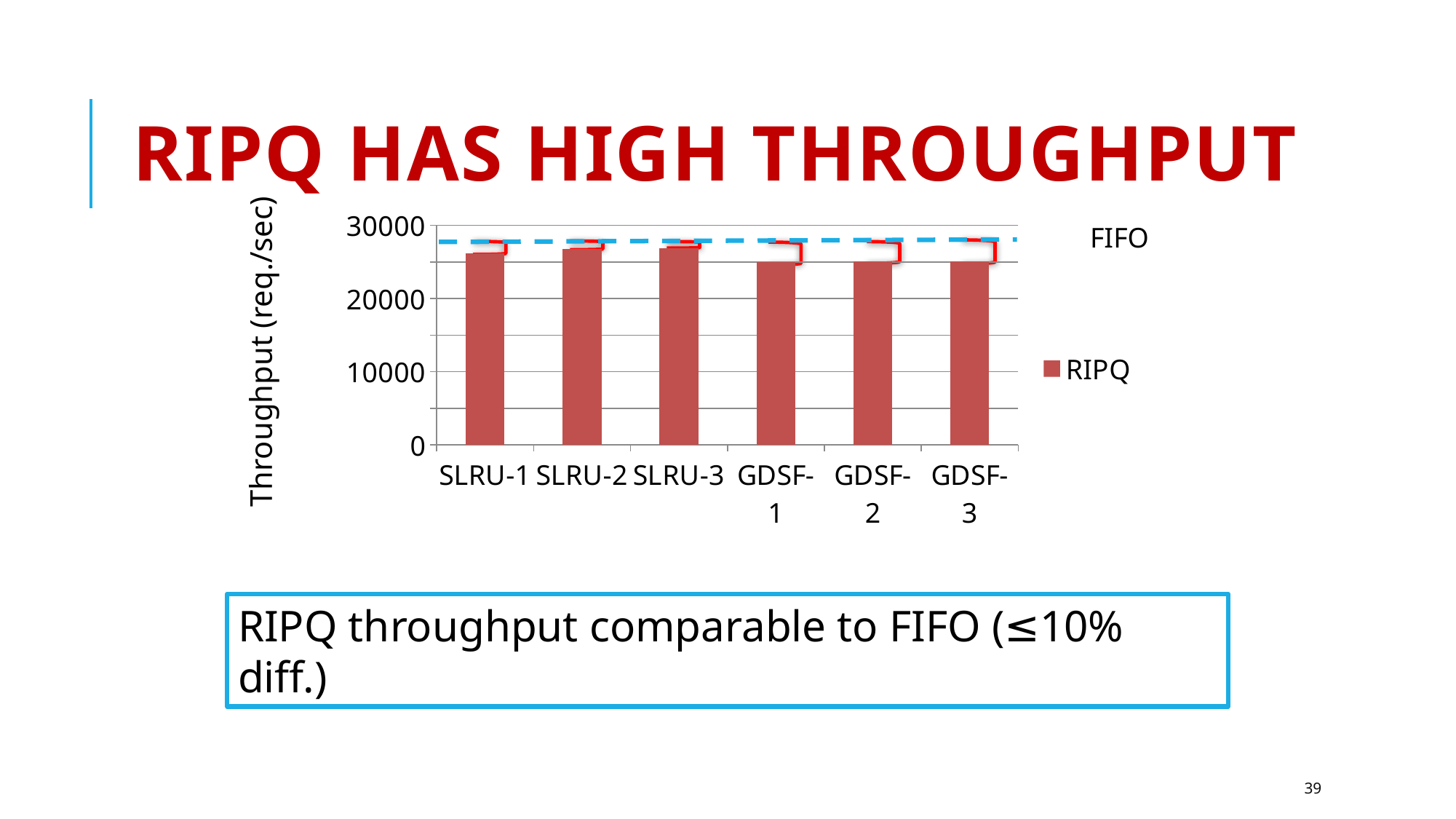
Which has the larger RIPQ throughput, SLRU-2 or GDSF-2? SLRU-2 Is the RIPQ value for GDSF-3 greater or less than 30000? less How many series does the chart's legend list? 1 Is the RIPQ value for SLRU-1 greater or less than 20000? greater How many categories are shown on the x axis of the chart? 6 What is the label of the y axis of the chart? Throughput (req./sec) Is the FIFO throughput line above or below 20000? above What kind of chart is shown on the slide? bar chart What is the highest value shown on the y axis of the chart? 30000 Which series is shown as a dashed line in the chart? FIFO